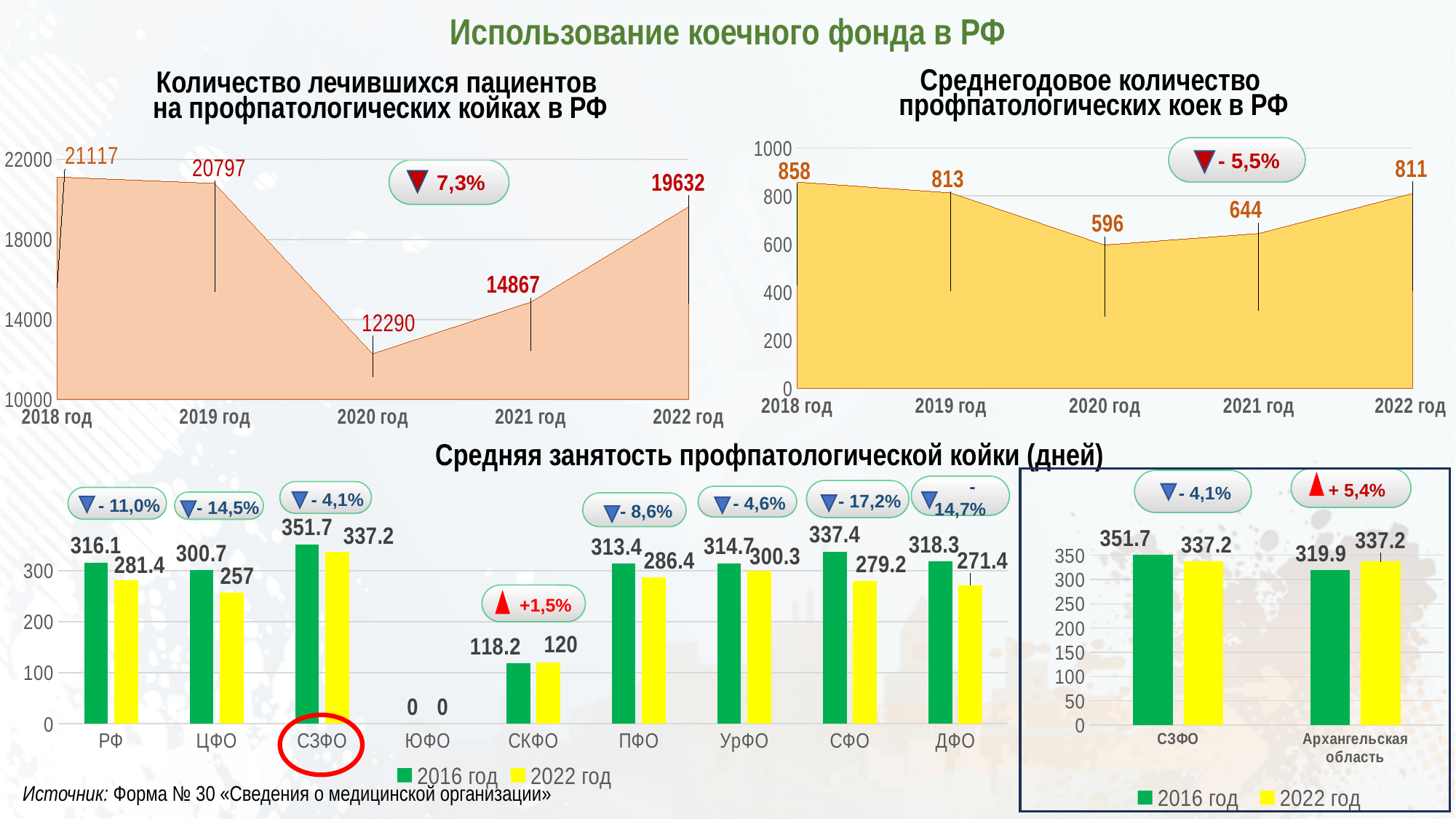
In the chart 'Количество лечившихся пациентов на профпатологических койках в РФ', what is the value for 2020 год? 12290 In the chart 'Среднегодовое количество профпатологических коек в РФ', how many years are plotted? 5 In the chart 'Средняя занятость профпатологической койки (дней)' on the left, which is larger for СФО: the 2016 год value or the 2022 год value? 2016 год In the chart 'Средняя занятость профпатологической койки (дней)' on the left, which district has the highest 2016 год value? СЗФО In the chart 'Количество лечившихся пациентов на профпатологических койках в РФ', which year has the lowest value? 2020 год In the chart 'Среднегодовое количество профпатологических коек в РФ', what is the value for 2021 год? 644 In the chart 'Средняя занятость профпатологической койки (дней)' on the left, what is the 2022 год value for ЦФО? 257 In the bottom-right bar chart, what is the difference between the 2016 год values for СЗФО and Архангельская область? 31.8 In the chart 'Средняя занятость профпатологической койки (дней)' on the left, how many series does the legend list? 2 What kind of chart is 'Среднегодовое количество профпатологических коек в РФ'? area chart In the chart 'Среднегодовое количество профпатологических коек в РФ', which year has the highest value? 2018 год In the chart 'Количество лечившихся пациентов на профпатологических койках в РФ', what is the difference between the 2018 год and 2022 год values? 1485